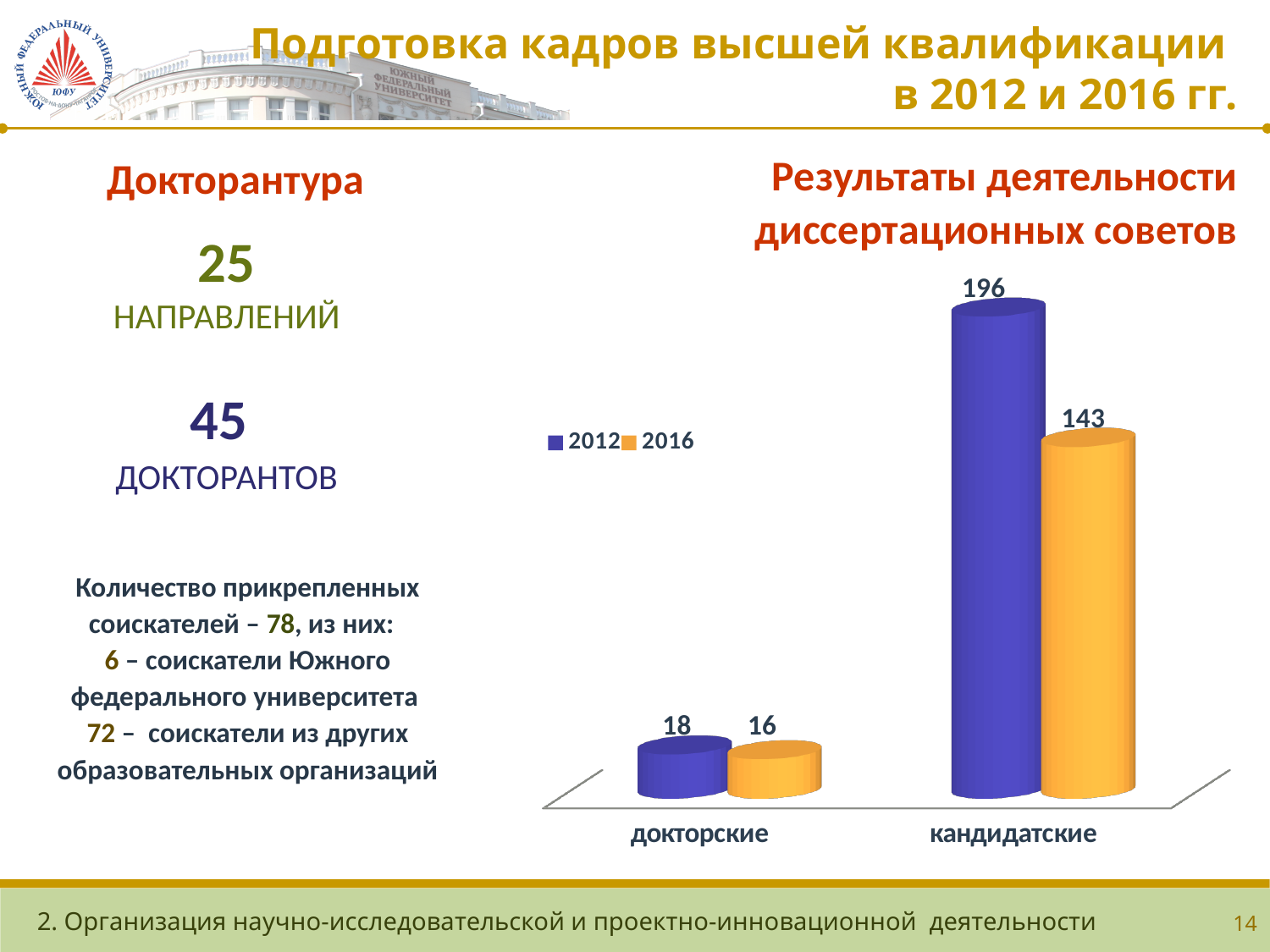
How many categories are shown on the x axis of the chart? 2 What is the value for кандидатские in 2016? 143 What kind of chart is shown on the slide? bar chart What is the value for докторские in 2016? 16 Which category has the highest value in the 2012 series? кандидатские Which category has the lowest value in the 2016 series? докторские What is the value for кандидатские in 2012? 196 What is the value for докторские in 2012? 18 What is the difference between the 2012 and 2016 values for кандидатские? 53 How many series does the legend list? 2 Which is larger for кандидатские: the 2012 value or the 2016 value? 2012 What is the difference between the 2012 and 2016 values for докторские? 2